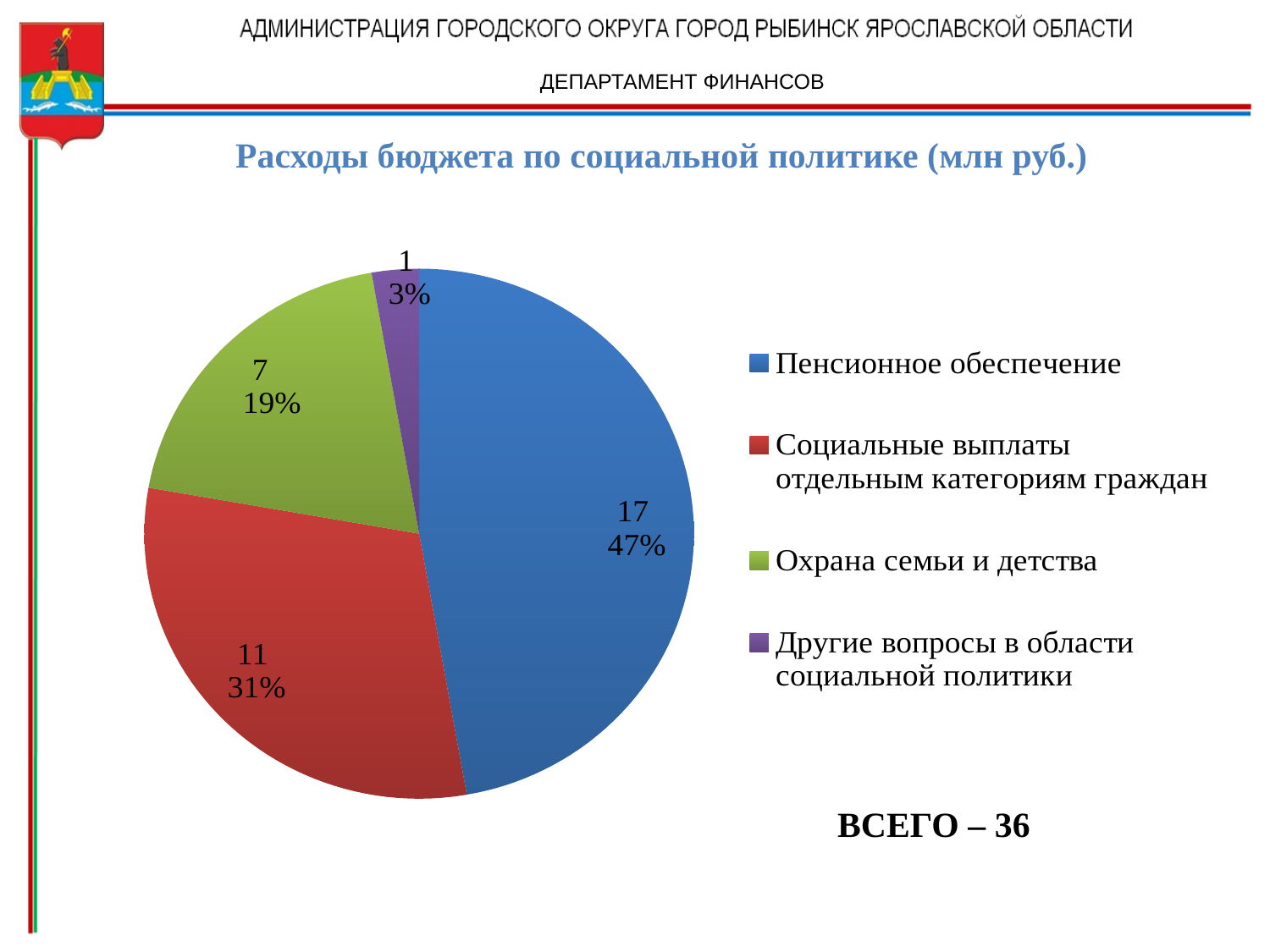
What is the difference between the values for Пенсионное обеспечение and Социальные выплаты отдельным категориям граждан? 6 What is the value for Охрана семьи и детства? 7 What type of chart is shown on the slide? pie chart What share of the pie does Охрана семьи и детства represent? 19% Which category has the smallest slice? Другие вопросы в области социальной политики What is the value for Социальные выплаты отдельным категориям граждан? 11 What is the title of the chart? Расходы бюджета по социальной политике (млн руб.) Which category has the largest slice? Пенсионное обеспечение How many categories does the pie chart have? 4 What is the value for Пенсионное обеспечение? 17 What is the value for Другие вопросы в области социальной политики? 1 What share of the pie does Социальные выплаты отдельным категориям граждан represent? 31%